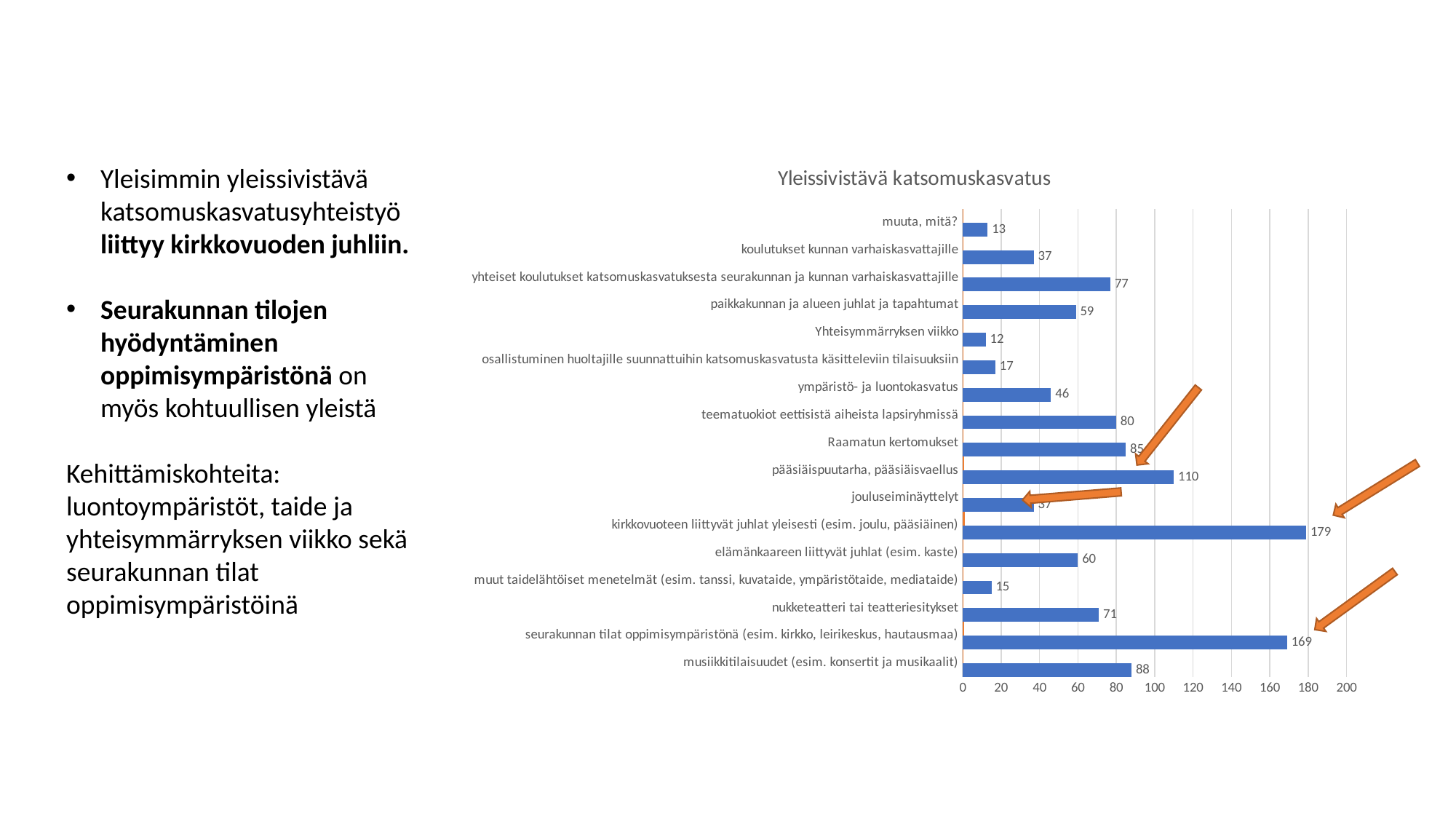
How many categories are shown in the chart? 17 What is the value for 'Raamatun kertomukset'? 85 What type of chart is shown on the slide? bar chart What is the value for 'kirkkovuoteen liittyvät juhlat yleisesti (esim. joulu, pääsiäinen)'? 179 What is the value for 'Yhteisymmärryksen viikko'? 12 Which is larger, the value for 'pääsiäispuutarha, pääsiäisvaellus' or the value for 'musiikkitilaisuudet (esim. konsertit ja musikaalit)'? pääsiäispuutarha, pääsiäisvaellus What is the value for 'seurakunnan tilat oppimisympäristönä (esim. kirkko, leirikeskus, hautausmaa)'? 169 Which category has the lowest value? Yhteisymmärryksen viikko What is the difference between the values for 'kirkkovuoteen liittyvät juhlat yleisesti (esim. joulu, pääsiäinen)' and 'seurakunnan tilat oppimisympäristönä (esim. kirkko, leirikeskus, hautausmaa)'? 10 Which category has the highest value? kirkkovuoteen liittyvät juhlat yleisesti (esim. joulu, pääsiäinen) What is the title of the chart? Yleissivistävä katsomuskasvatus Is the value for 'nukketeatteri tai teatteriesitykset' greater or less than 80? less